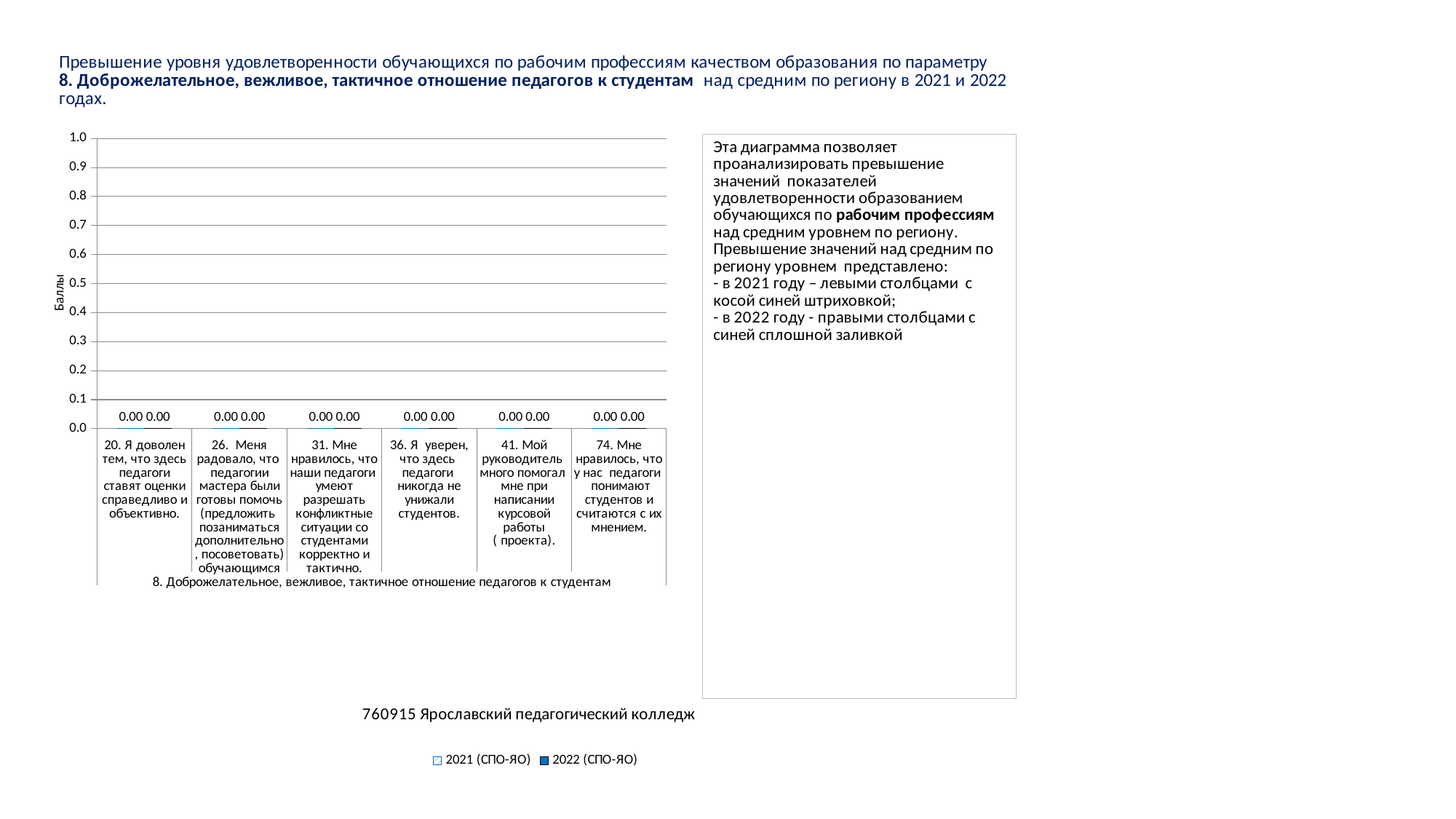
What is the value for 2022 (СПО-ЯО) for category 74 ("Мне нравилось, что у нас педагоги понимают студентов и считаются с их мнением")? 0.00 Is the value for 2022 (СПО-ЯО) for category 31 ("Мне нравилось, что наши педагоги умеют разрешать конфликтные ситуации...") greater or less than 0.1? less What are the two series named in the chart legend? 2021 (СПО-ЯО) and 2022 (СПО-ЯО) What is the difference between the 2021 (СПО-ЯО) and 2022 (СПО-ЯО) values for category 26 ("Меня радовало, что педагоги мастера были готовы помочь...")? 0.00 Do the plotted values rise, fall, or stay the same across the categories on the x axis? Stay the same What kind of chart is shown on the slide? Bar chart What is the label of the vertical axis of the chart? Баллы How many categories are shown on the x axis of the chart? 6 What is the value for 2021 (СПО-ЯО) for category 41 ("Мой руководитель много помогал мне при написании курсовой работы (проекта)")? 0.00 What is the value for 2021 (СПО-ЯО) for category 20 ("Я доволен тем, что здесь педагоги ставят оценки справедливо и объективно")? 0.00 How many series does the chart legend list? 2 What is the value for 2022 (СПО-ЯО) for category 36 ("Я уверен, что здесь педагоги никогда не унижали студентов")? 0.00